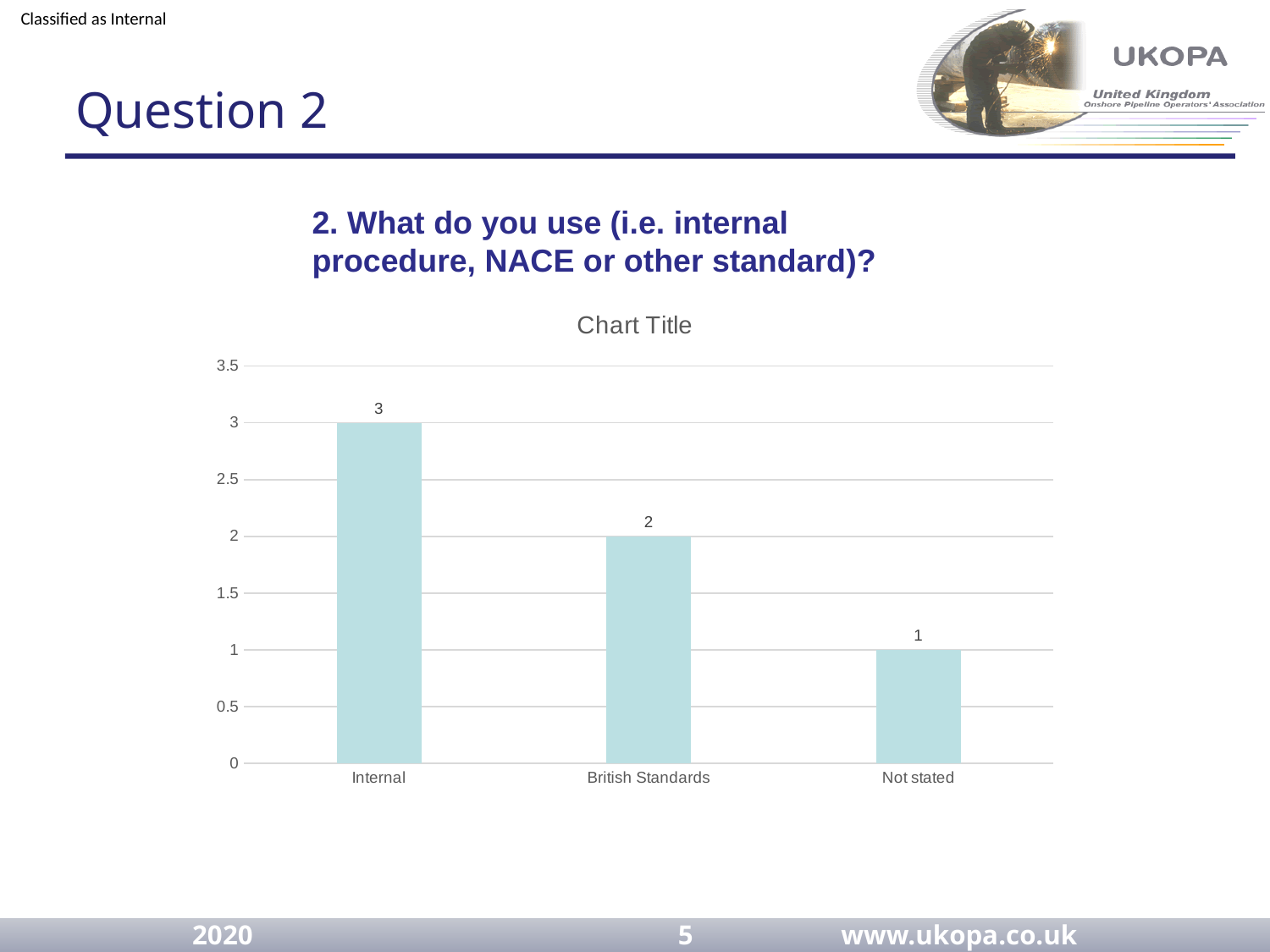
Do the values rise or fall from left to right along the x axis? fall What kind of chart is shown on the slide? bar chart What is the value for Internal? 3 Which category has the lowest value? Not stated What is the difference between the values for Internal and Not stated? 2 Is the value for Internal greater or less than 2.5? greater Which category has the highest value? Internal What is the value for British Standards? 2 Which is larger, the value for British Standards or the value for Not stated? British Standards What is the value for Not stated? 1 How many categories are shown on the x axis? 3 What is the difference between the values for Internal and British Standards? 1